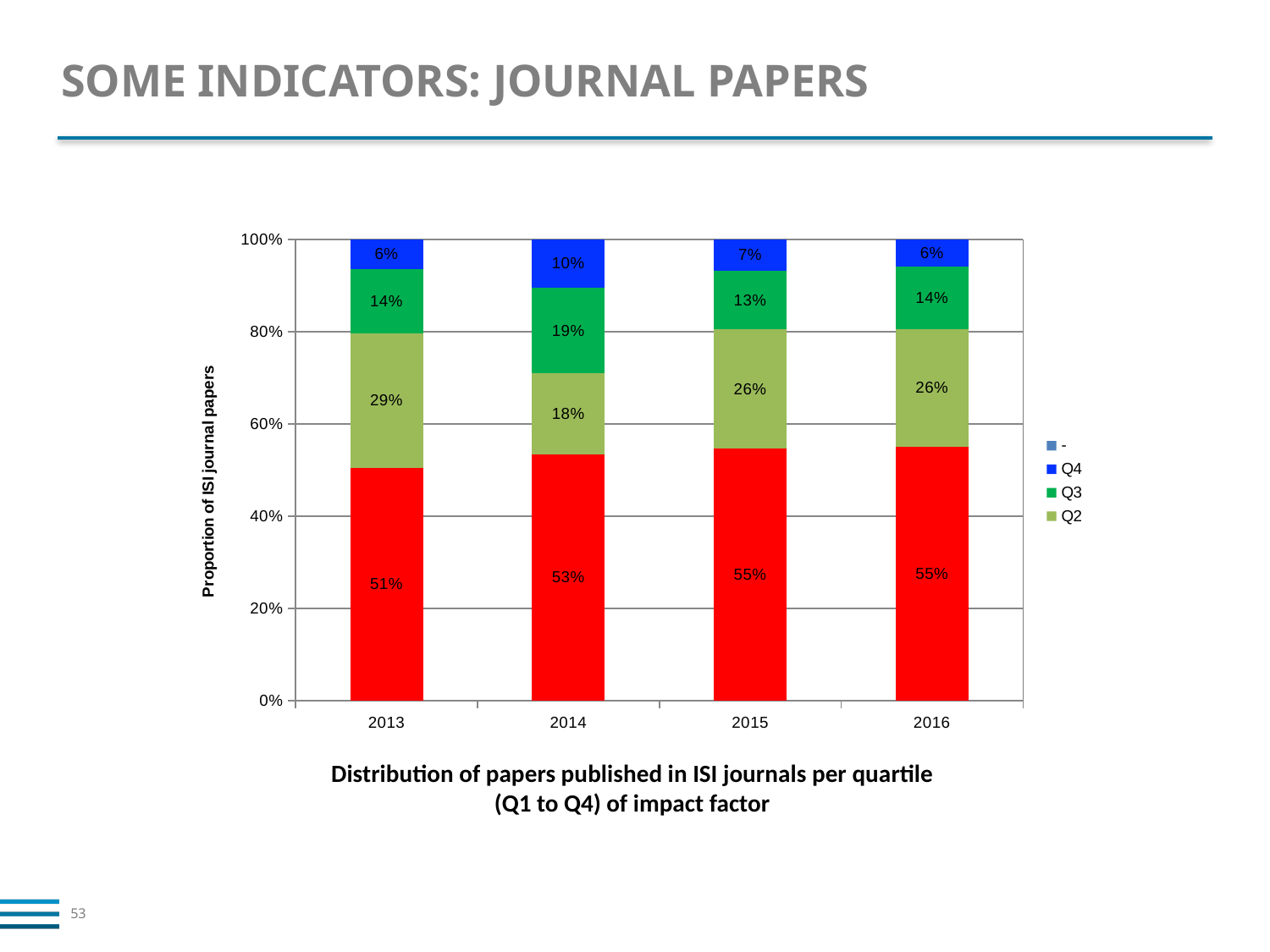
By how much does the Q3 value in 2014 exceed the Q3 value in 2013? 5% How many years are shown on the x axis of the chart? 4 How many entries does the chart's legend list? 4 What is the Q3 value for 2015? 13% What is the Q2 value for 2013? 29% In which year is the Q2 share lowest? 2014 What is the value of the bottom red segment for 2016? 55% What kind of chart is shown on the slide? Stacked bar chart What is the title of the chart's vertical axis? Proportion of ISI journal papers What is the Q4 value for 2014? 10% In 2015, which is larger, the Q2 value or the Q3 value? Q2 In which year is the Q4 share highest? 2014